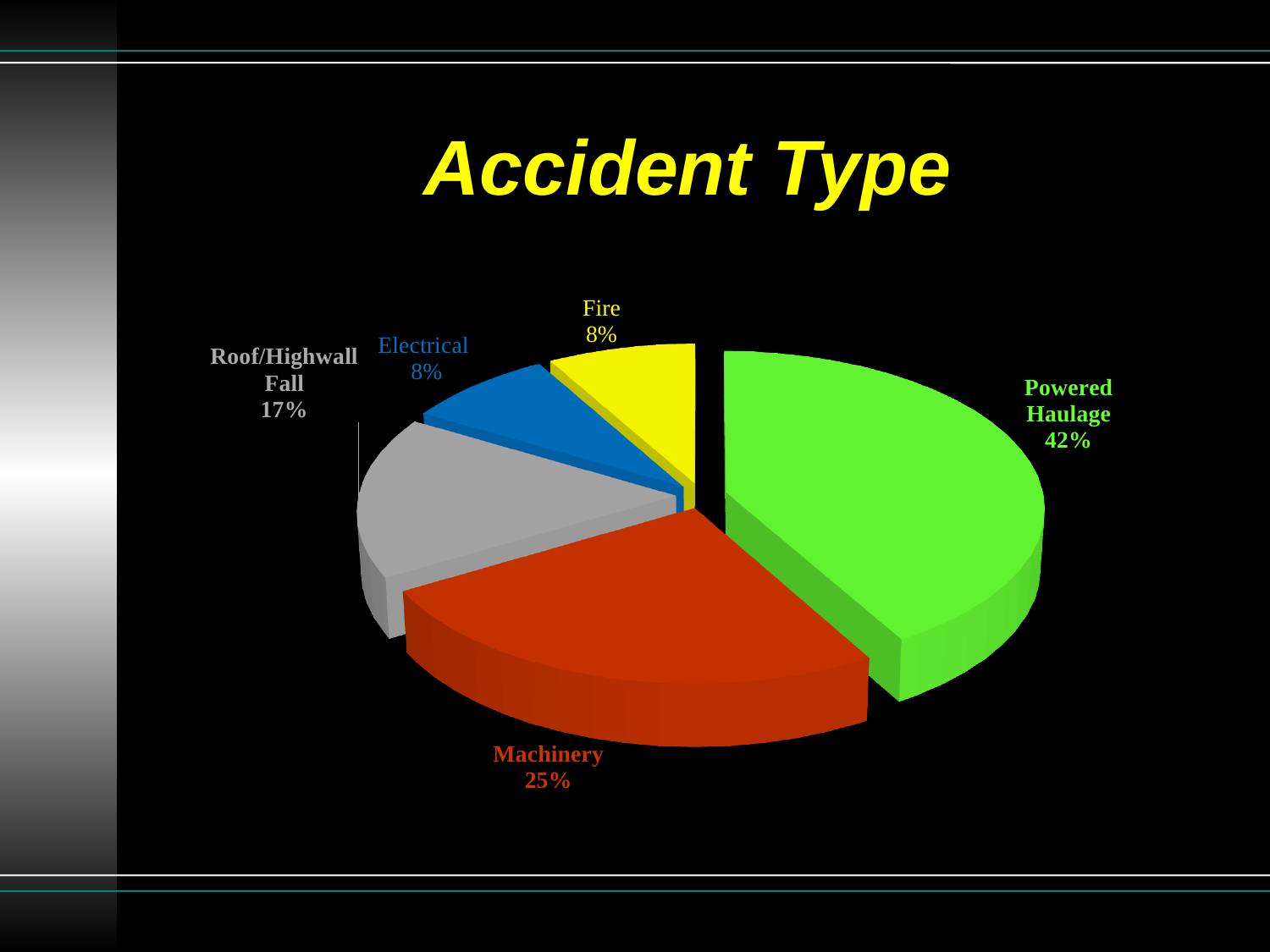
What is the title of the chart? Accident Type How many slices does the pie chart have? 5 What share of the pie does Powered Haulage represent? 42% What is the value shown for Machinery? 25% What kind of chart is shown on the slide? Pie chart Which accident type has the largest share of the pie? Powered Haulage What percentage is shown for Roof/Highwall Fall? 17% What percentage is shown for Electrical? 8% What is the difference in percentage points between Machinery and Roof/Highwall Fall? 8 What is the difference in percentage points between Powered Haulage and Machinery? 17 What colour is the Machinery slice? Red Which is larger, the share for Roof/Highwall Fall or the share for Fire? Roof/Highwall Fall